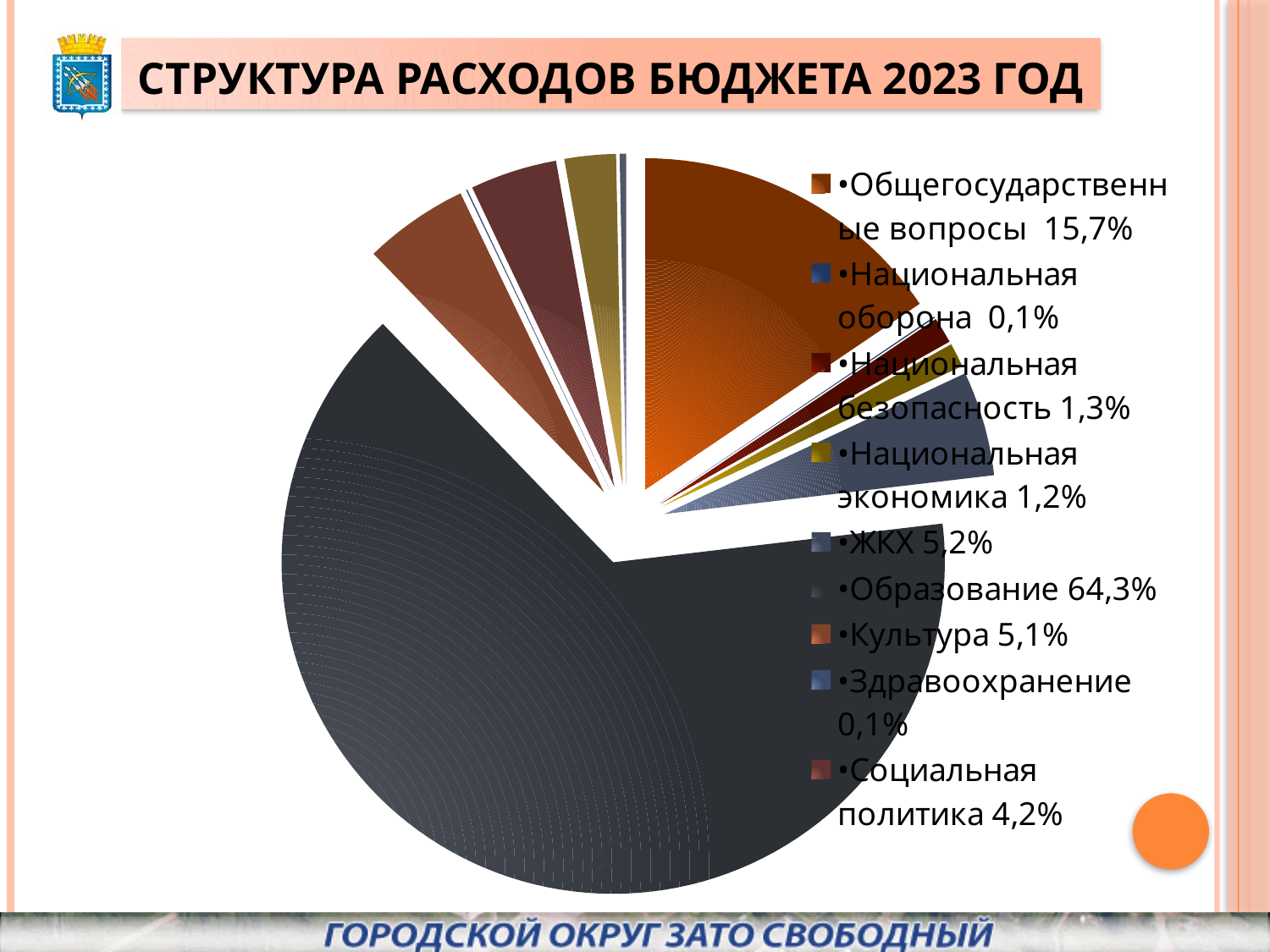
What share is shown for Национальная безопасность? 1,3% How many categories does the legend list? 9 Which category has the largest share of the budget expenditure? Образование What kind of chart is shown on the slide? Pie chart What share is shown for Общегосударственные вопросы? 15,7% What share of the budget expenditure goes to Образование? 64,3% What is the title of the chart on the slide? СТРУКТУРА РАСХОДОВ БЮДЖЕТА 2023 ГОД What percentage is shown for Социальная политика? 4,2% What percentage is shown for ЖКХ? 5,2% Which is larger: the share for Образование or the share for Общегосударственные вопросы? Образование What is the difference between the shares for Культура and Социальная политика? 0,9% What is the difference between the shares for Образование and Общегосударственные вопросы? 48,6%